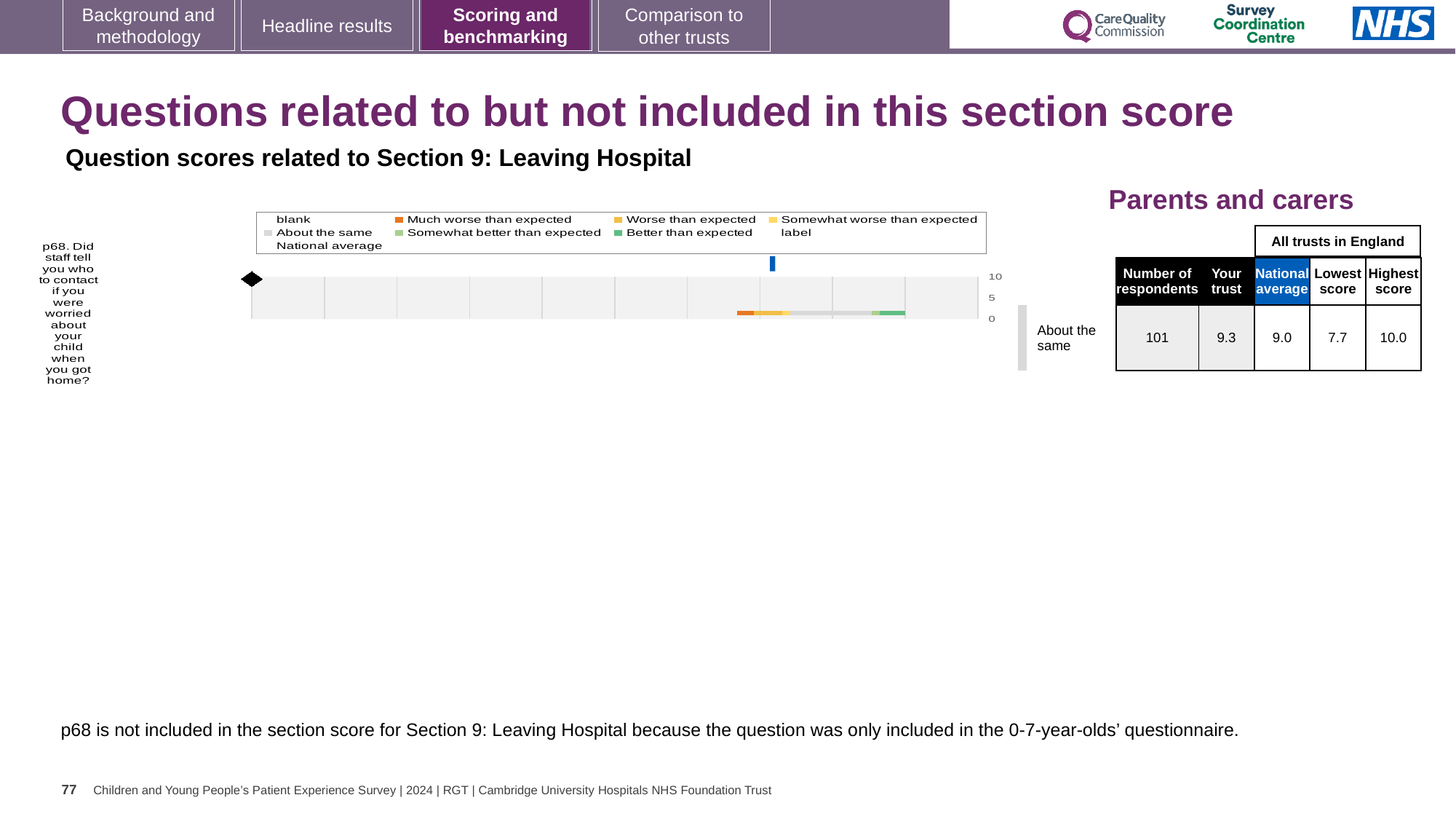
What is the Lowest score among all trusts in England for p68? 7.7 What is the Highest score among all trusts in England for p68? 10.0 What is the highest value shown on the chart's axis? 10 What is the 'Your trust' score for p68? 9.3 Is the 'Your trust' score for p68 larger or smaller than the National average? larger What is the National average score for p68? 9.0 How many survey questions are plotted in the chart? 1 Which question number is plotted in the chart? p68 What kind of chart is shown on the slide? bar chart What benchmark category is the trust's result for p68 labelled as? About the same What is the difference between the Highest score and the Lowest score for p68? 2.3 How many respondents answered p68? 101